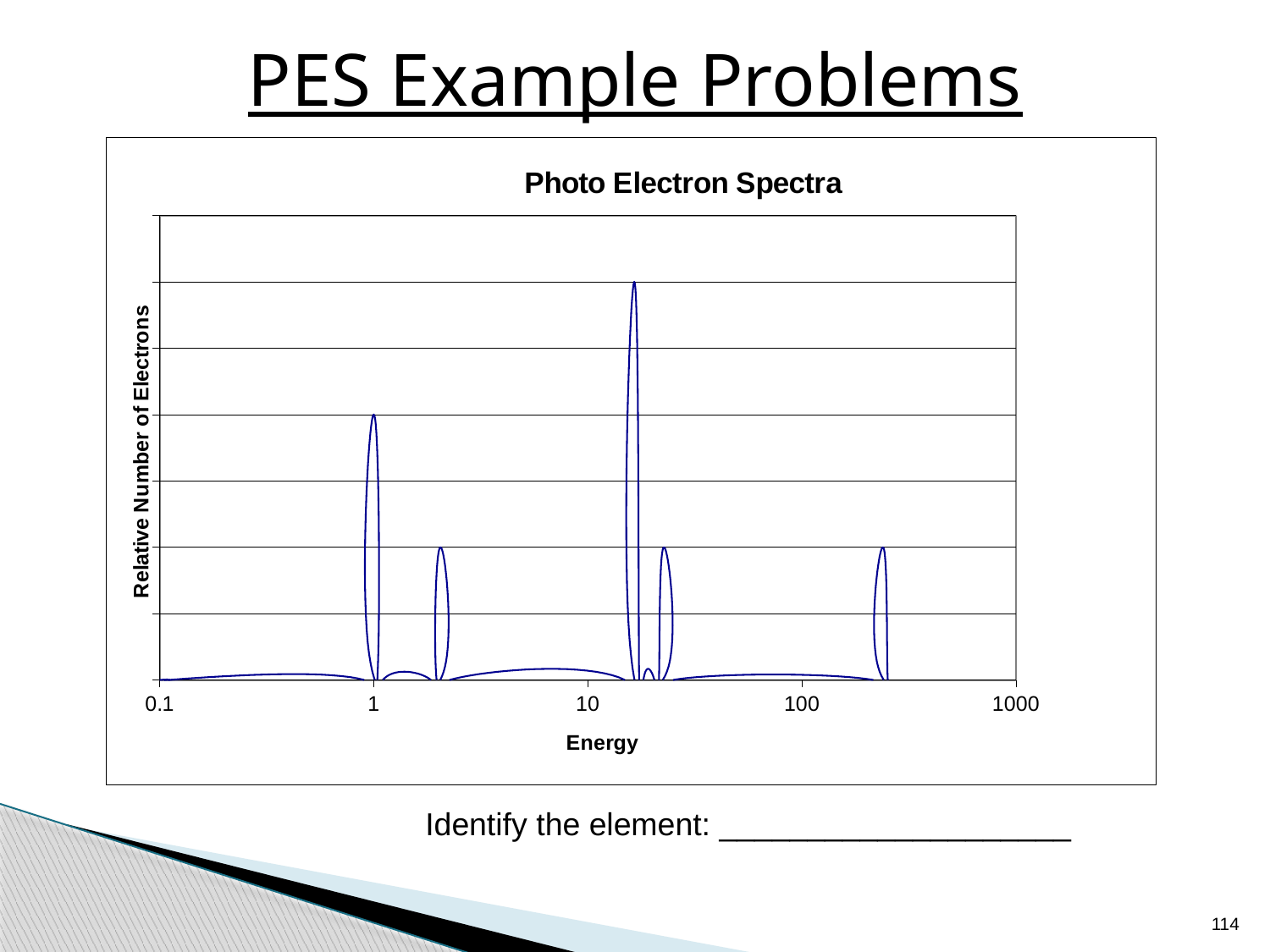
Is the rightmost peak located at an Energy greater or less than 100? greater What is the largest value labelled on the Energy axis? 1000 Is the leftmost peak located at an Energy greater or less than 10? less What is the title of the chart? Photo Electron Spectra What is the label on the vertical axis of the chart? Relative Number of Electrons Which is taller: the peak at Energy 1 or the peak just to its right between 1 and 10? the peak at Energy 1 How many peaks are plotted in the spectrum? 5 What kind of chart is shown on the slide? line chart Between which two labelled Energy values does the tallest peak occur? 10 and 100 What is the smallest value labelled on the Energy axis? 0.1 Is the tallest peak located at an Energy greater or less than 10? greater How many tick labels are shown on the Energy axis? 5